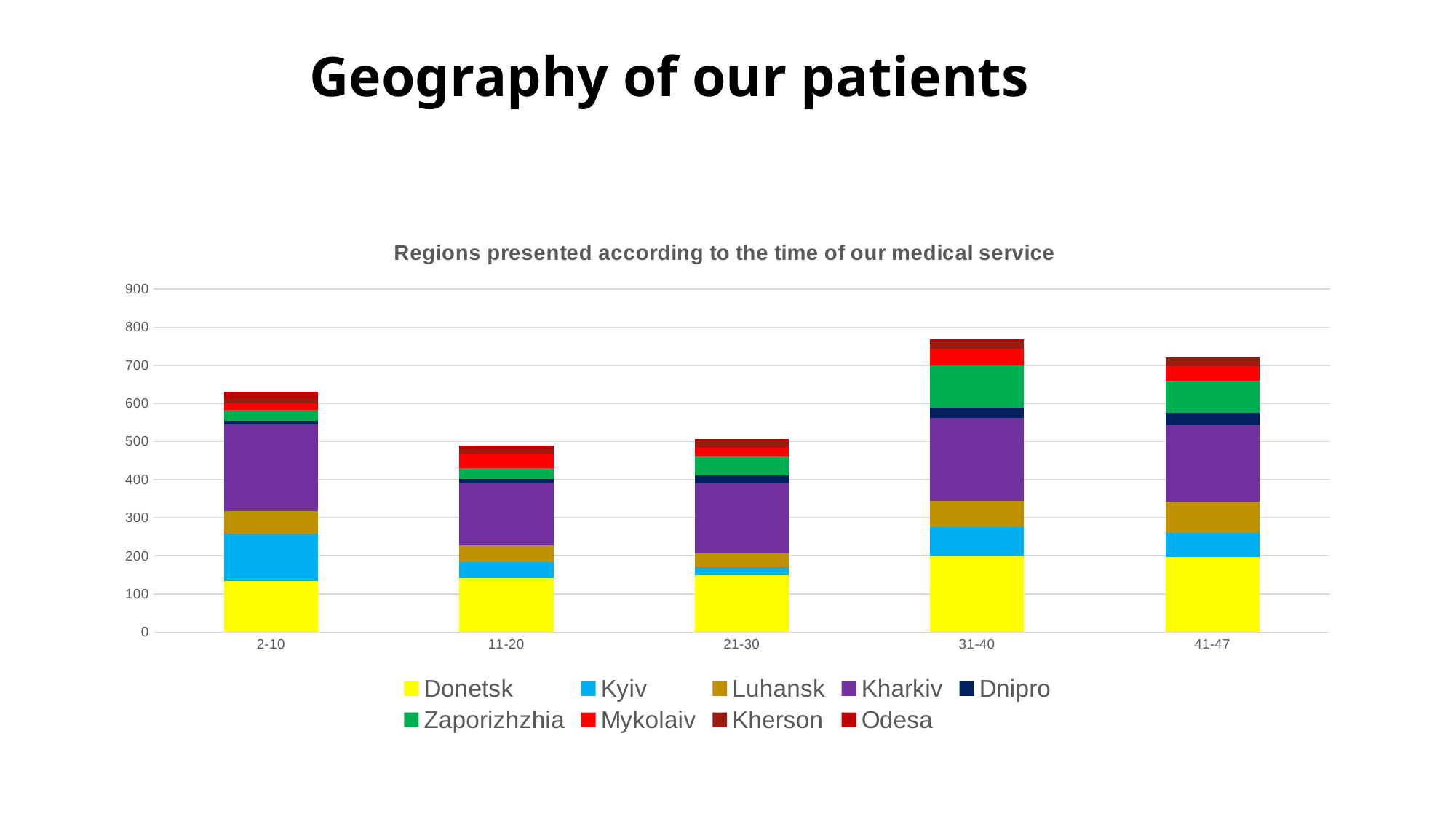
Which category has the highest total stacked bar? 31-40 Is the total stacked bar for 31-40 greater or less than 700? greater What is the title of the chart? Regions presented according to the time of our medical service What kind of chart is shown on the slide? Stacked bar chart Which has the larger total stacked bar, 2-10 or 11-20? 2-10 Is the Donetsk value for 2-10 greater or less than 200? less Is the total stacked bar for 21-30 greater or less than 600? less Which has the larger total stacked bar, 31-40 or 41-47? 31-40 Which series is shown in yellow in the chart's legend? Donetsk How many series does the chart's legend list? 9 How many categories are shown on the x axis of the chart? 5